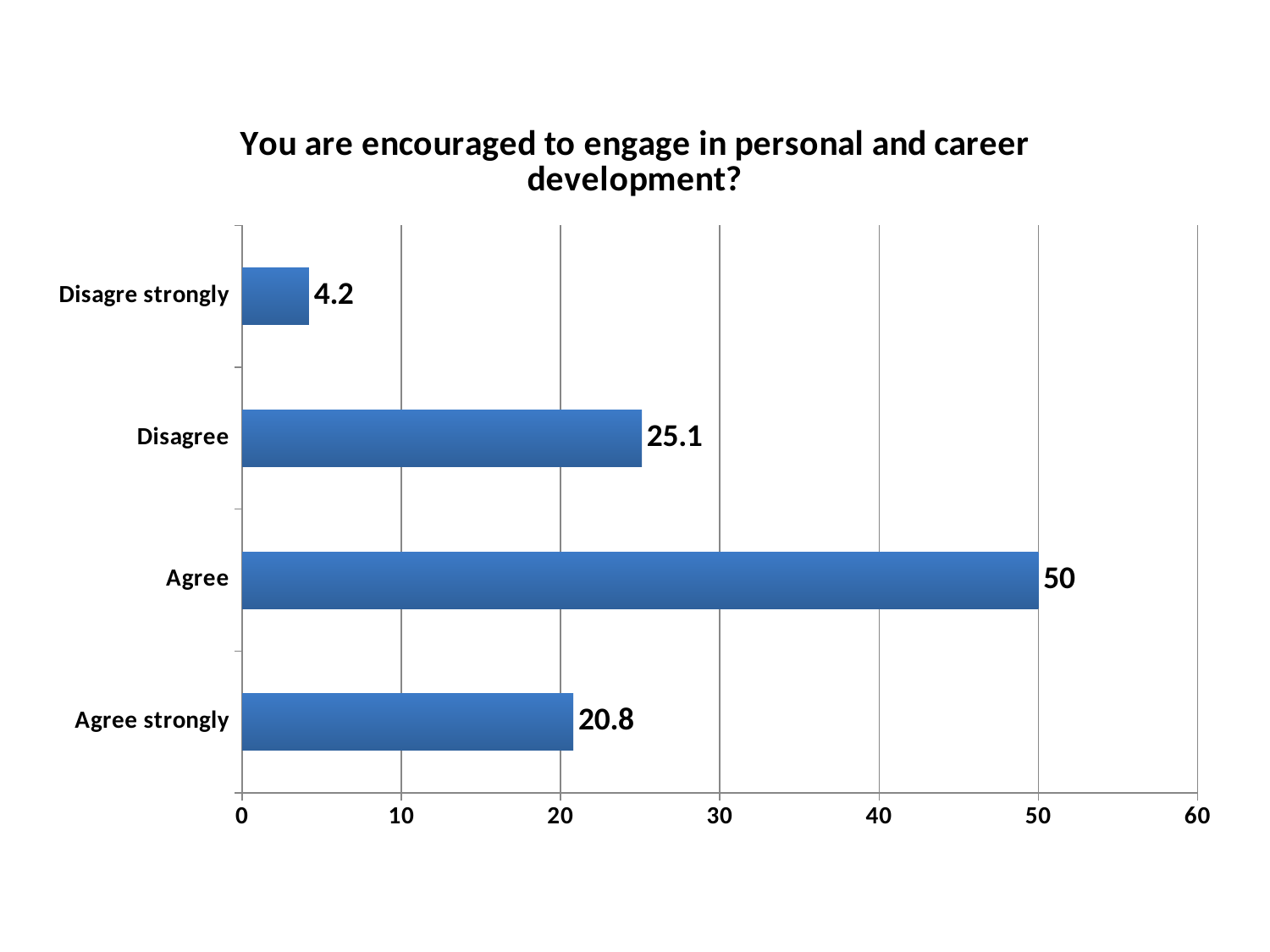
What is the value for Disagre strongly? 4.2 What is the difference between the values for Disagree and Agree strongly? 4.3 What is the difference between the values for Agree and Disagree? 24.9 Which is larger, the value for Disagree or the value for Agree strongly? Disagree Which category has the lowest value? Disagre strongly What kind of chart is shown on the slide? bar chart Which category has the highest value? Agree What is the value for Agree? 50 What is the value for Disagree? 25.1 What is the value for Agree strongly? 20.8 Is the value for Agree strongly greater or less than 30? less How many categories are shown in the chart? 4